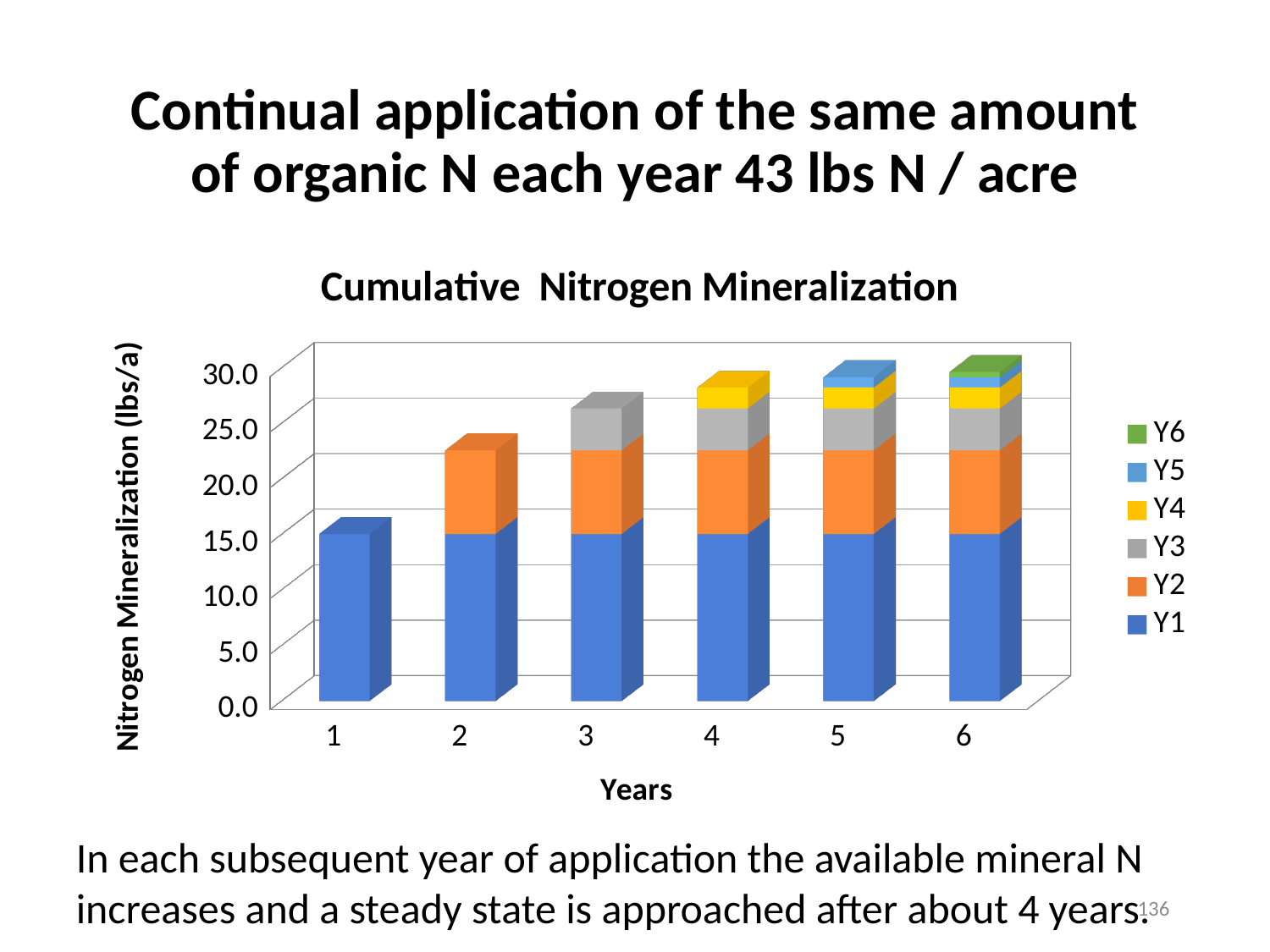
Which year has the tallest stacked bar? 6 How many series does the legend list? 6 Do the stacked bar totals rise or fall from year 1 to year 6? rise What is the title of the chart? Cumulative Nitrogen Mineralization Which is larger, the total for year 1 or the total for year 4? year 4 What kind of chart is shown on the slide? bar chart Is the total for year 2 greater or less than 20.0? greater What is the label on the y axis? Nitrogen Mineralization (lbs/a) Is the total for year 6 greater or less than 25.0? greater How many years are shown along the x axis? 6 Is the total for year 1 greater or less than 20.0? less Which year has the shortest stacked bar? 1